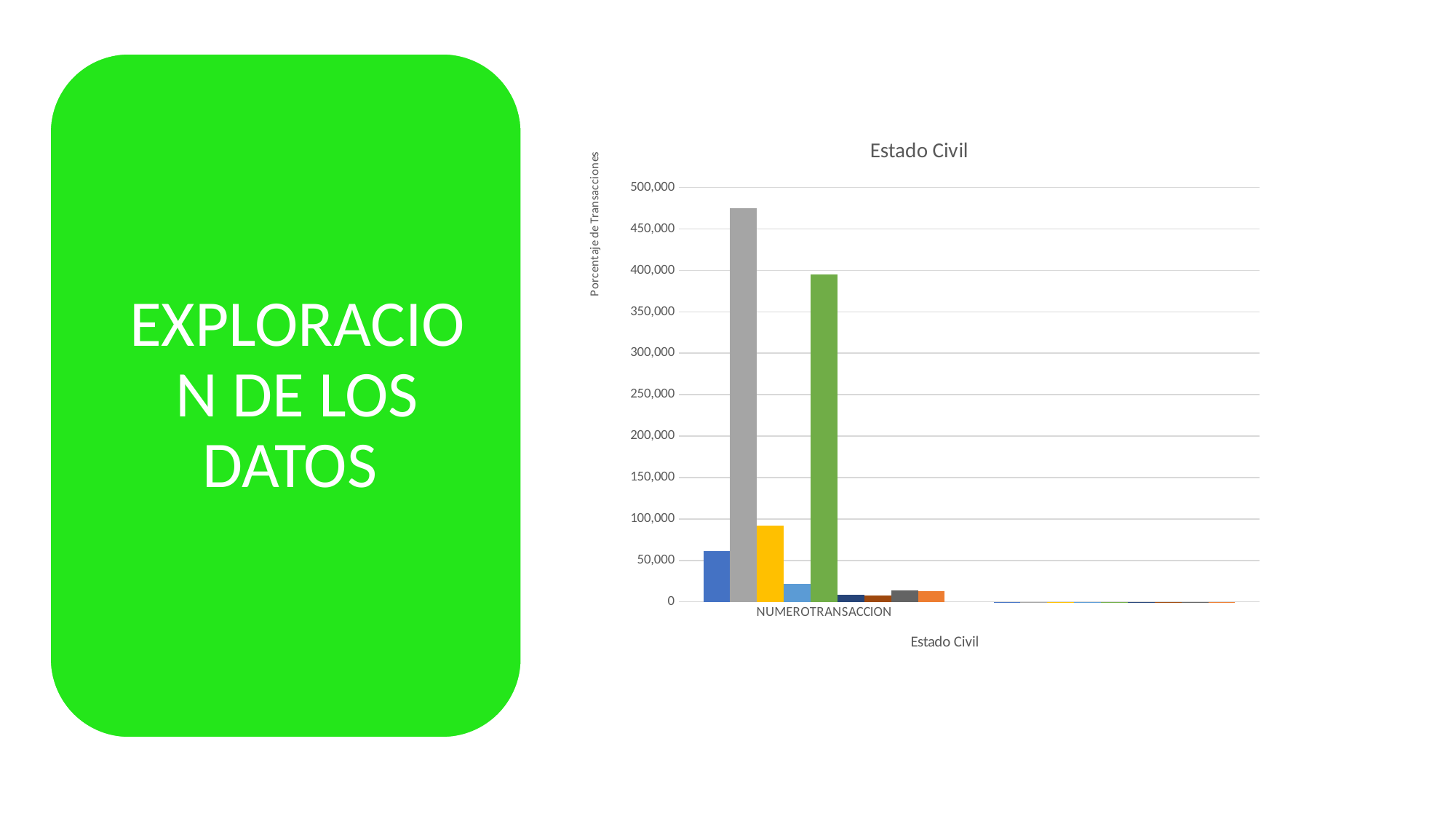
What is the title of the chart? Estado Civil Which colour bar is the tallest in the chart? gray What is the label on the vertical axis of the chart? Porcentaje de Transacciones Is the value of the dark blue (first) bar greater or less than 50,000? greater What kind of chart is shown on the slide? bar chart Which is larger, the gray bar or the green bar? gray bar Is the value of the yellow bar greater or less than 100,000? less Which is larger, the yellow bar or the light blue bar? yellow bar Is the value of the gray bar greater or less than 450,000? greater